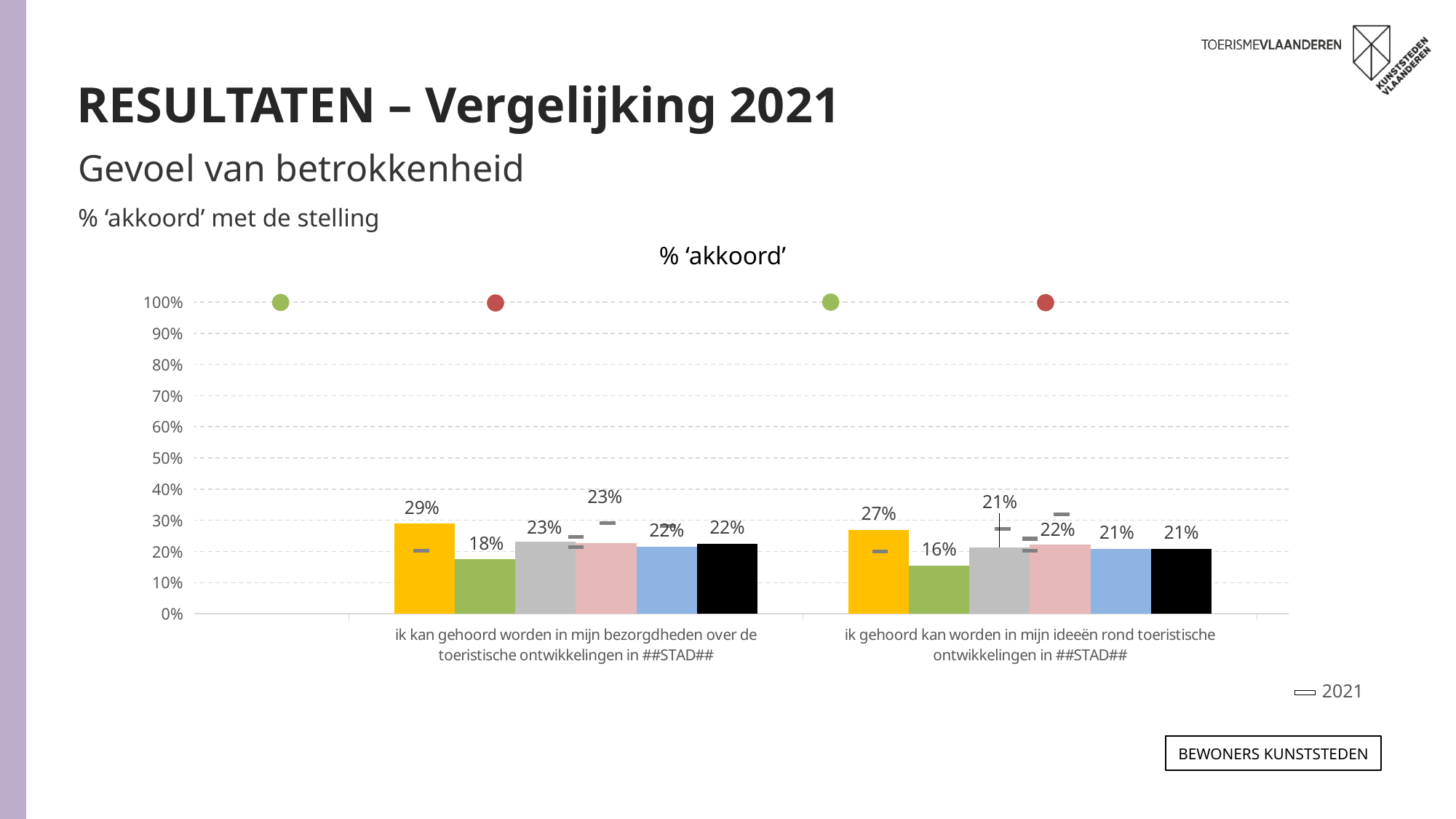
How many statement categories are shown on the x axis of the chart? 2 Is the value of the yellow bar for the statement 'ik gehoord kan worden in mijn ideeën rond toeristische ontwikkelingen in ##STAD##' greater or less than 50%? less Which year does the legend entry with the horizontal marker refer to? 2021 What is the value of the green bar for the statement 'ik gehoord kan worden in mijn ideeën rond toeristische ontwikkelingen in ##STAD##'? 16% What is the value of the black bar for the statement 'ik kan gehoord worden in mijn bezorgdheden over de toeristische ontwikkelingen in ##STAD##'? 22% What is the value of the yellow bar for the statement 'ik kan gehoord worden in mijn bezorgdheden over de toeristische ontwikkelingen in ##STAD##'? 29% What is the title of the chart? % ‘akkoord’ What kind of chart is shown on the slide? bar chart Is the yellow bar higher for the first statement (bezorgdheden) or for the second statement (ideeën)? the first statement (29% vs 27%) Which coloured bar is the lowest for the statement 'ik kan gehoord worden in mijn bezorgdheden over de toeristische ontwikkelingen in ##STAD##'? the green bar (18%) What is the difference between the yellow bar and the green bar for the statement 'ik kan gehoord worden in mijn bezorgdheden over de toeristische ontwikkelingen in ##STAD##'? 11 percentage points Which coloured bar is the highest for the statement 'ik gehoord kan worden in mijn ideeën rond toeristische ontwikkelingen in ##STAD##'? the yellow bar (27%)